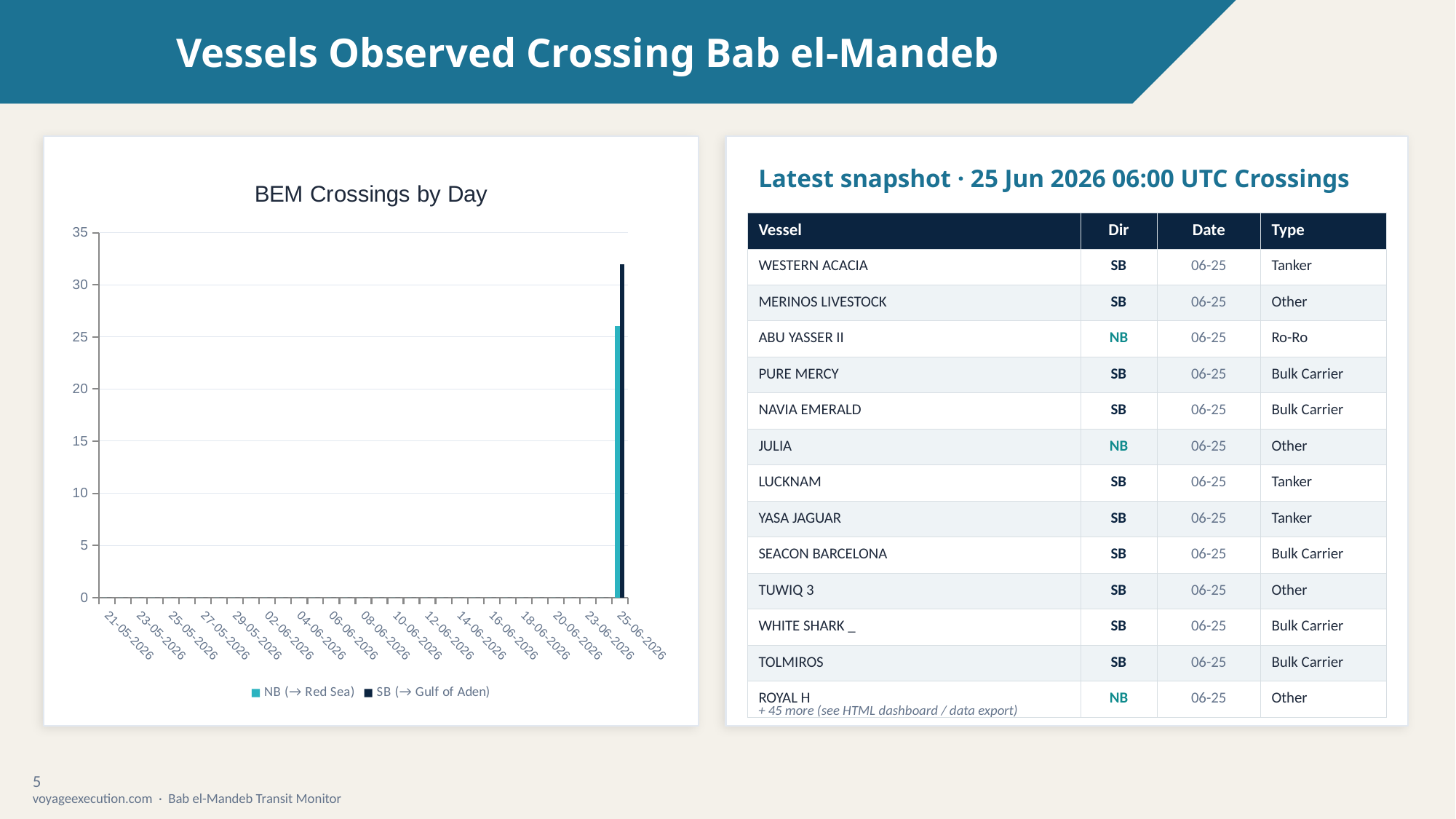
In "BEM Crossings by Day", is the SB (→ Gulf of Aden) value on 25-06-2026 greater or less than 35? less In "BEM Crossings by Day", on which date do the bars appear? 25-06-2026 How many series does the legend of "BEM Crossings by Day" list? 2 In "BEM Crossings by Day", is the NB (→ Red Sea) value on 25-06-2026 greater or less than 20? greater What kind of chart is "BEM Crossings by Day"? bar chart In "BEM Crossings by Day", which series has the taller bar on 25-06-2026, NB (→ Red Sea) or SB (→ Gulf of Aden)? SB (→ Gulf of Aden) In "BEM Crossings by Day", is the NB (→ Red Sea) value on 25-06-2026 greater or less than 30? less What is the highest value shown on the y axis of "BEM Crossings by Day"? 35 What are the two series named in the legend of "BEM Crossings by Day"? NB (→ Red Sea) and SB (→ Gulf of Aden) What is the title of the chart on the left of the slide? BEM Crossings by Day